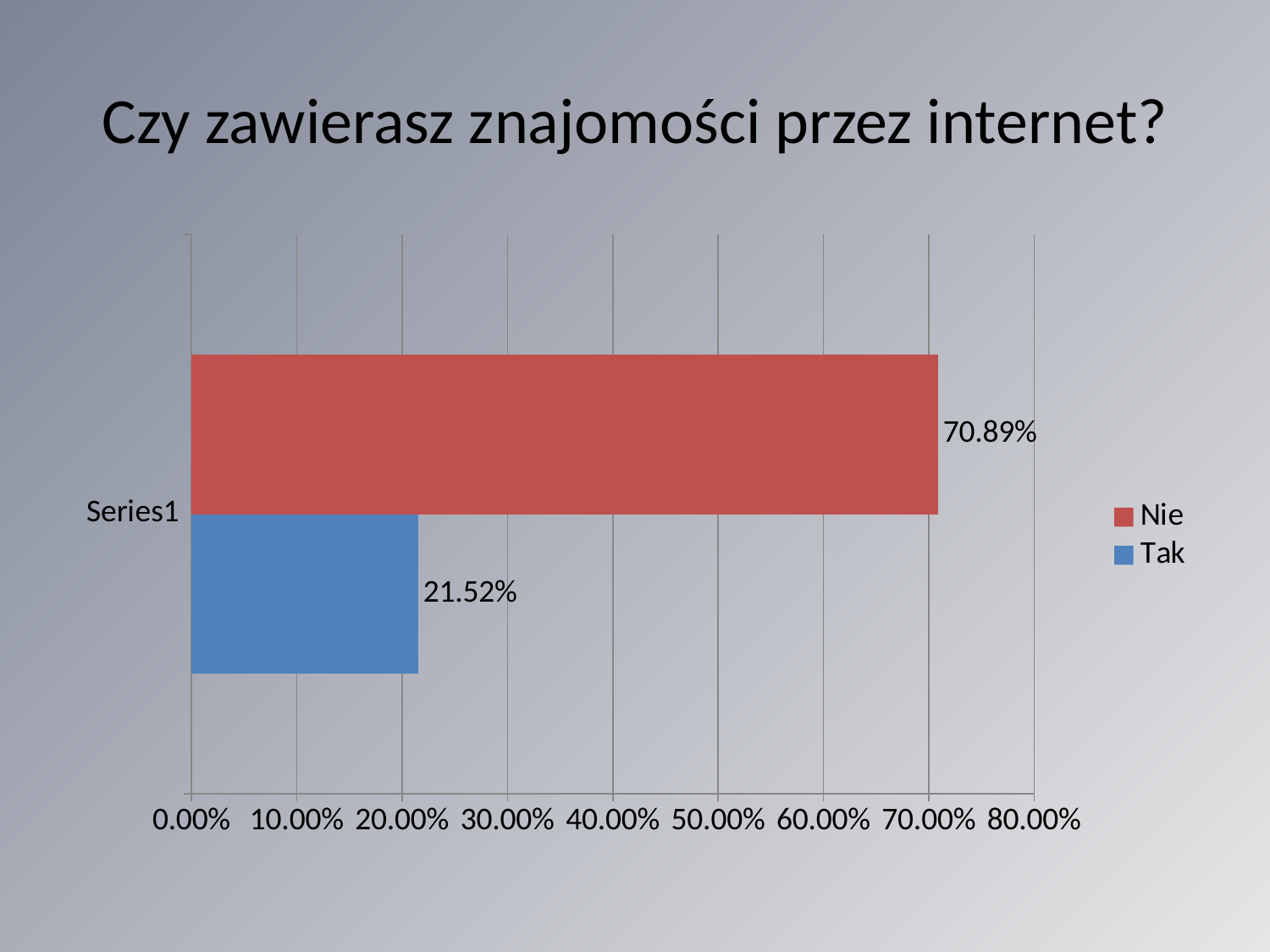
What is the value for Nie? 70.89% What is the difference between the values for Nie and Tak? 49.37% What is the title of the slide? Czy zawierasz znajomości przez internet? Is the value for Nie greater or less than 60.00%? greater What kind of chart is shown on the slide? bar chart Which series has the highest value? Nie What colour is the bar for Tak? blue How many series does the legend list? 2 What is the value for Tak? 21.52% Is the value for Tak greater or less than 30.00%? less Which is larger, the value for Nie or the value for Tak? Nie Which series has the lowest value? Tak